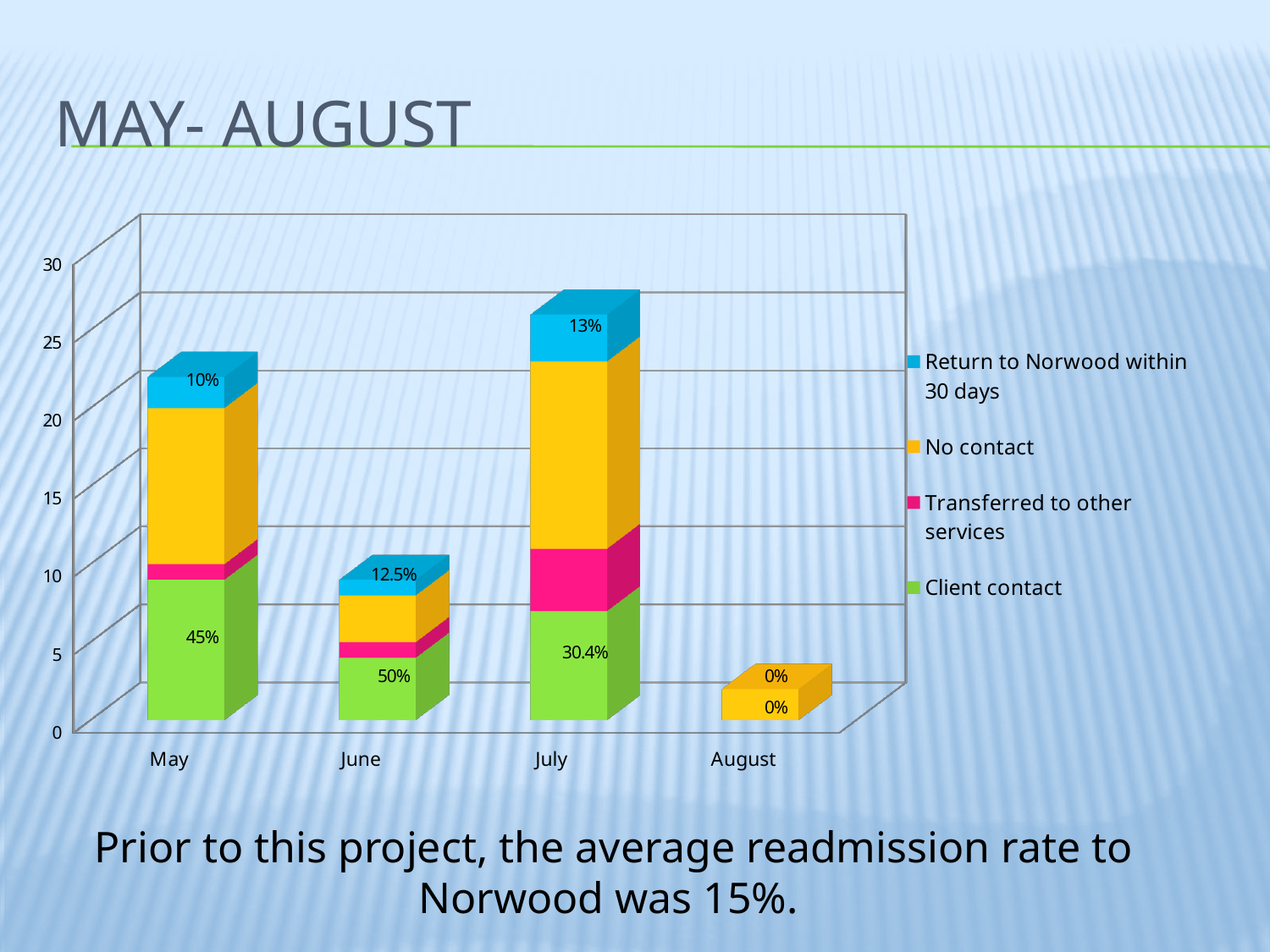
How many months are shown on the x axis of the chart? 4 What data label is shown on the Client contact segment for July? 30.4% What kind of chart is shown on the slide? Stacked bar chart What data label is shown on the Return to Norwood within 30 days segment for July? 13% Which month has the shortest stacked bar? August What data label is shown on the Client contact segment for June? 50% Which month has the taller stacked bar, May or June? May What data label is shown on the Return to Norwood within 30 days segment for June? 12.5% Is the total height of the stacked bar for July greater or less than 20? greater Which month has the tallest stacked bar? July What data label is shown on the Client contact segment for May? 45% How many series does the chart legend list? 4